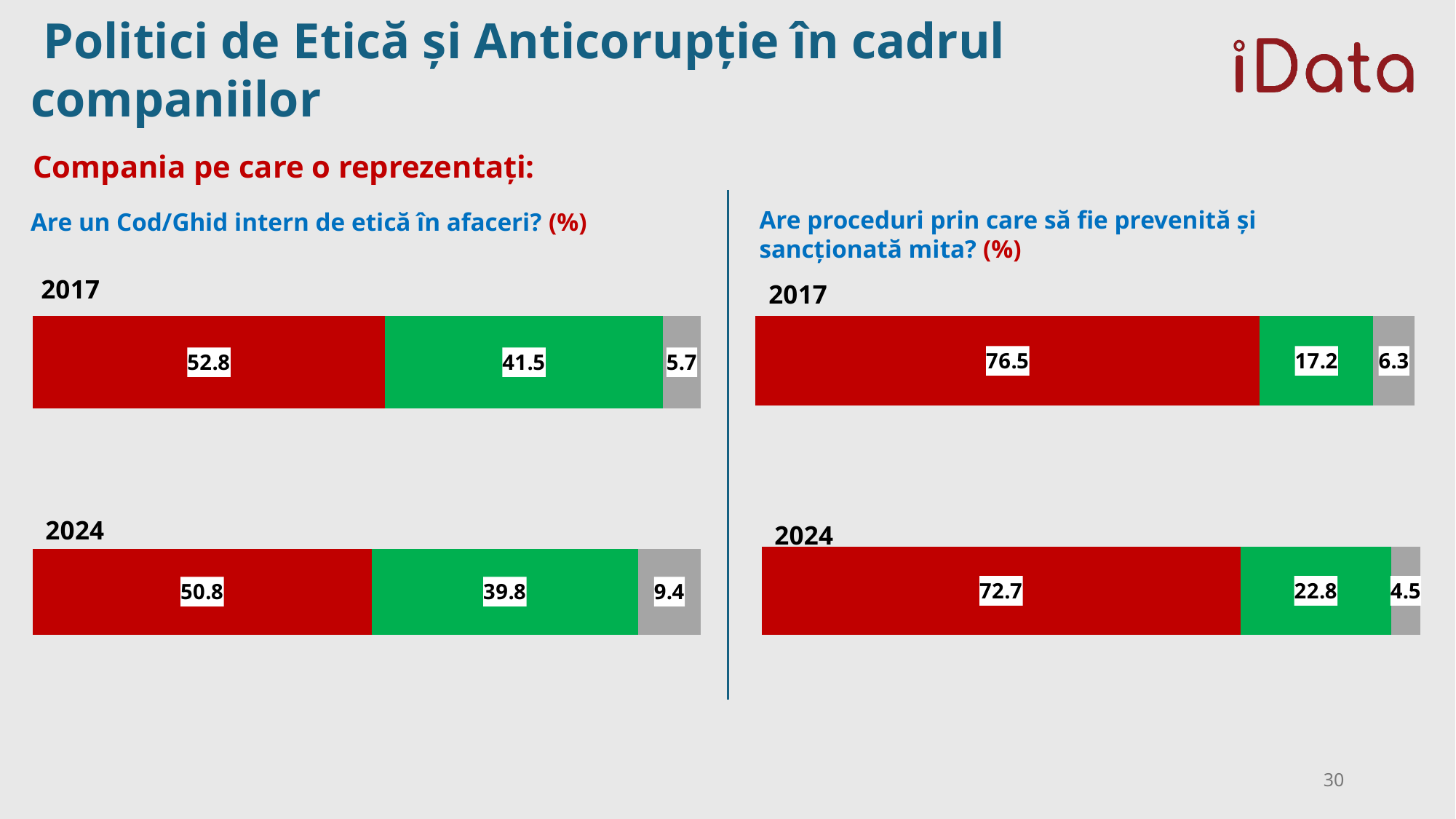
In the right chart (Are proceduri prin care să fie prevenită și sancționată mita?), which segment is the smallest in the 2024 bar? the grey segment (4.5) In the right chart (Are proceduri prin care să fie prevenită și sancționată mita?), what is the value of the green segment for 2024? 22.8 In the left chart (Are un Cod/Ghid intern de etică în afaceri?), what is the difference between the red segment values for 2017 and 2024? 2 In the right chart (Are proceduri prin care să fie prevenită și sancționată mita?), is the red segment larger in 2017 or in 2024? 2017 In the left chart (Are un Cod/Ghid intern de etică în afaceri?), what is the value of the red segment for 2017? 52.8 In the left chart (Are un Cod/Ghid intern de etică în afaceri?), how does the red segment value change from 2017 to 2024? It falls (from 52.8 to 50.8) How many bars (years) are shown in the left chart (Are un Cod/Ghid intern de etică în afaceri?)? 2 In the left chart (Are un Cod/Ghid intern de etică în afaceri?), which segment is the largest in the 2024 bar? the red segment (50.8) What type of chart is used on this slide? stacked bar chart In the left chart (Are un Cod/Ghid intern de etică în afaceri?), what is the value of the grey segment for 2024? 9.4 In the right chart (Are proceduri prin care să fie prevenită și sancționată mita?), what is the difference between the green segment values for 2024 and 2017? 5.6 In the right chart (Are proceduri prin care să fie prevenită și sancționată mita?), what is the value of the red segment for 2017? 76.5